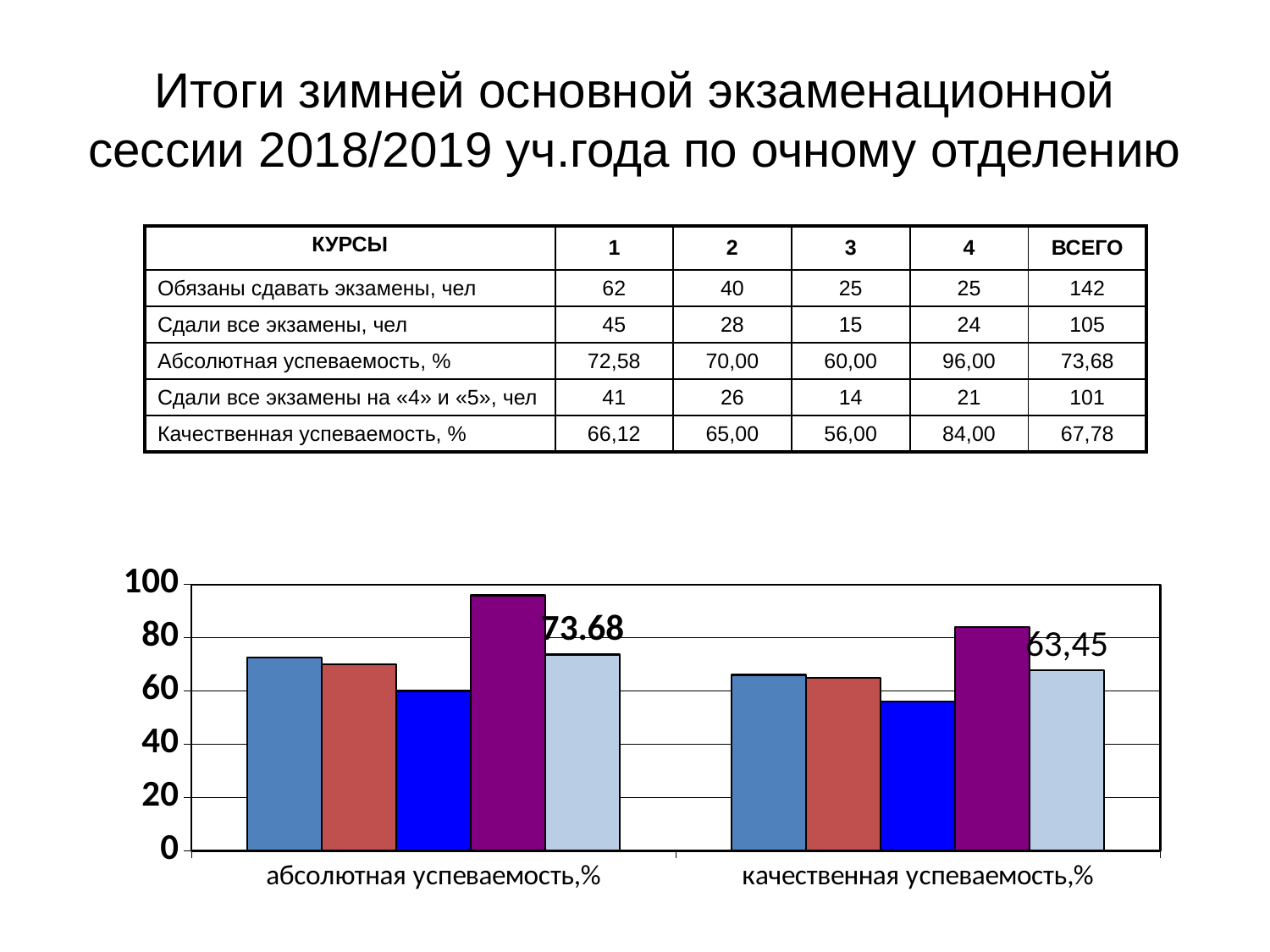
What value is printed as the data label on the rightmost (light blue) bar in the абсолютная успеваемость,% group? 73.68 How many categories are shown on the x axis of the chart? 2 Which bar is the highest in the качественная успеваемость,% group? the purple (fourth) bar Is the value of the bright blue (third) bar in the абсолютная успеваемость,% group greater or less than 80? less Which bar is the lowest in the качественная успеваемость,% group? the bright blue (third) bar What is the highest value shown on the y axis of the chart? 100 Is the value of the purple (fourth) bar in the абсолютная успеваемость,% group greater or less than 80? greater Is the value of the bright blue (third) bar in the качественная успеваемость,% group greater or less than 60? less What is the label of the first category on the x axis of the chart? абсолютная успеваемость,% What kind of chart is shown on the slide? bar chart Which bar is the tallest in the абсолютная успеваемость,% group: the purple (fourth) bar or the bright blue (third) bar? the purple (fourth) bar What value is printed as the data label on the rightmost (light blue) bar in the качественная успеваемость,% group? 63,45